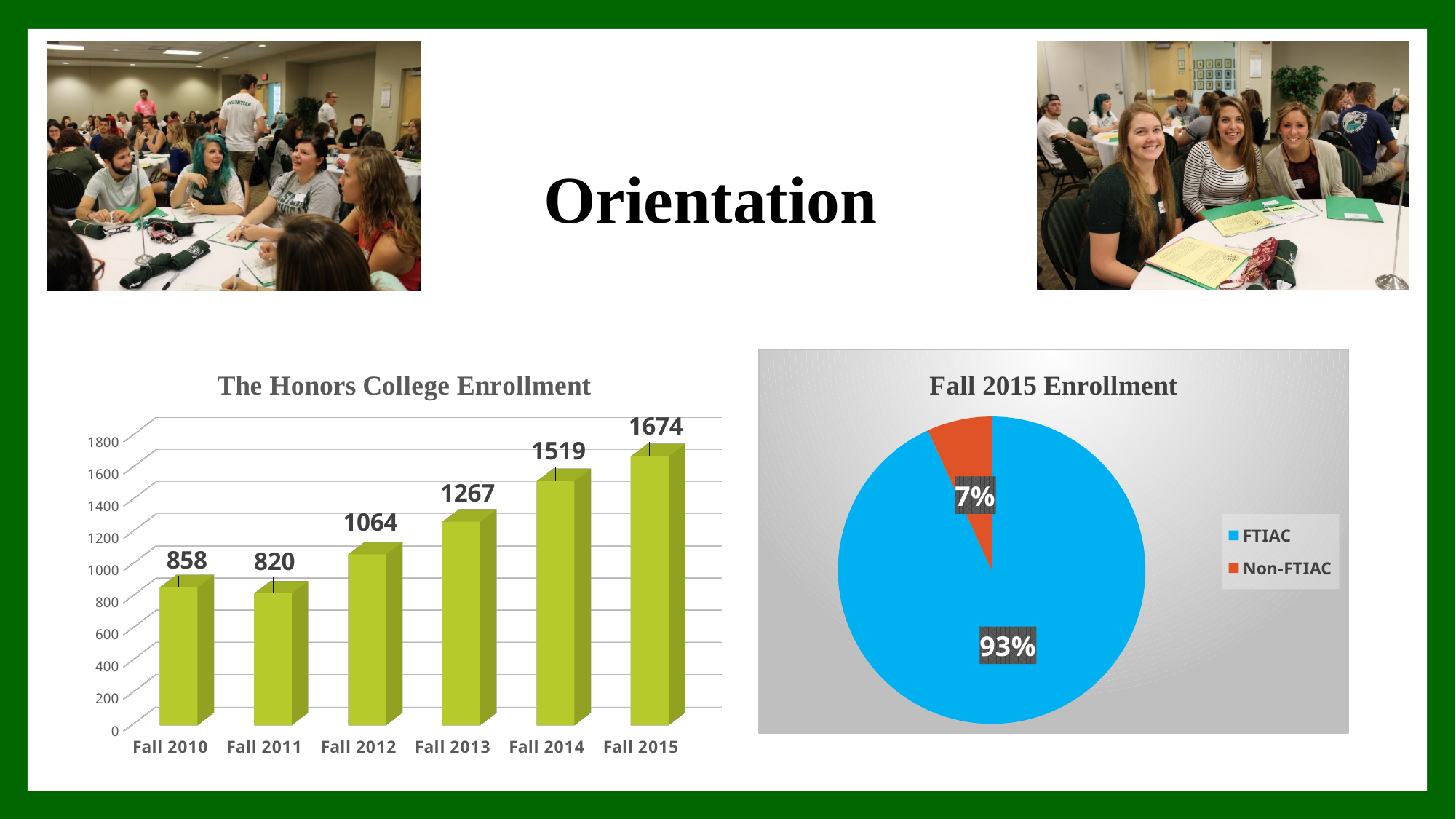
What kind of chart is "The Honors College Enrollment"? bar chart In the chart titled "Fall 2015 Enrollment", what share of the pie is Non-FTIAC? 7% In the chart titled "The Honors College Enrollment", which category has the highest value? Fall 2015 In the chart titled "The Honors College Enrollment", what is the difference between the Fall 2015 and Fall 2014 values? 155 In the chart titled "Fall 2015 Enrollment", how many entries does the legend list? 2 In the chart titled "Fall 2015 Enrollment", what colour is the FTIAC slice? blue In the chart titled "The Honors College Enrollment", which category has the lowest value? Fall 2011 In the chart titled "The Honors College Enrollment", what is the value for Fall 2010? 858 In the chart titled "The Honors College Enrollment", how many categories are shown on the x axis? 6 In the chart titled "The Honors College Enrollment", which is larger, the value for Fall 2012 or the value for Fall 2011? Fall 2012 In the chart titled "The Honors College Enrollment", what is the value for Fall 2013? 1267 In the chart titled "The Honors College Enrollment", do the values generally rise or fall from Fall 2011 to Fall 2015? rise